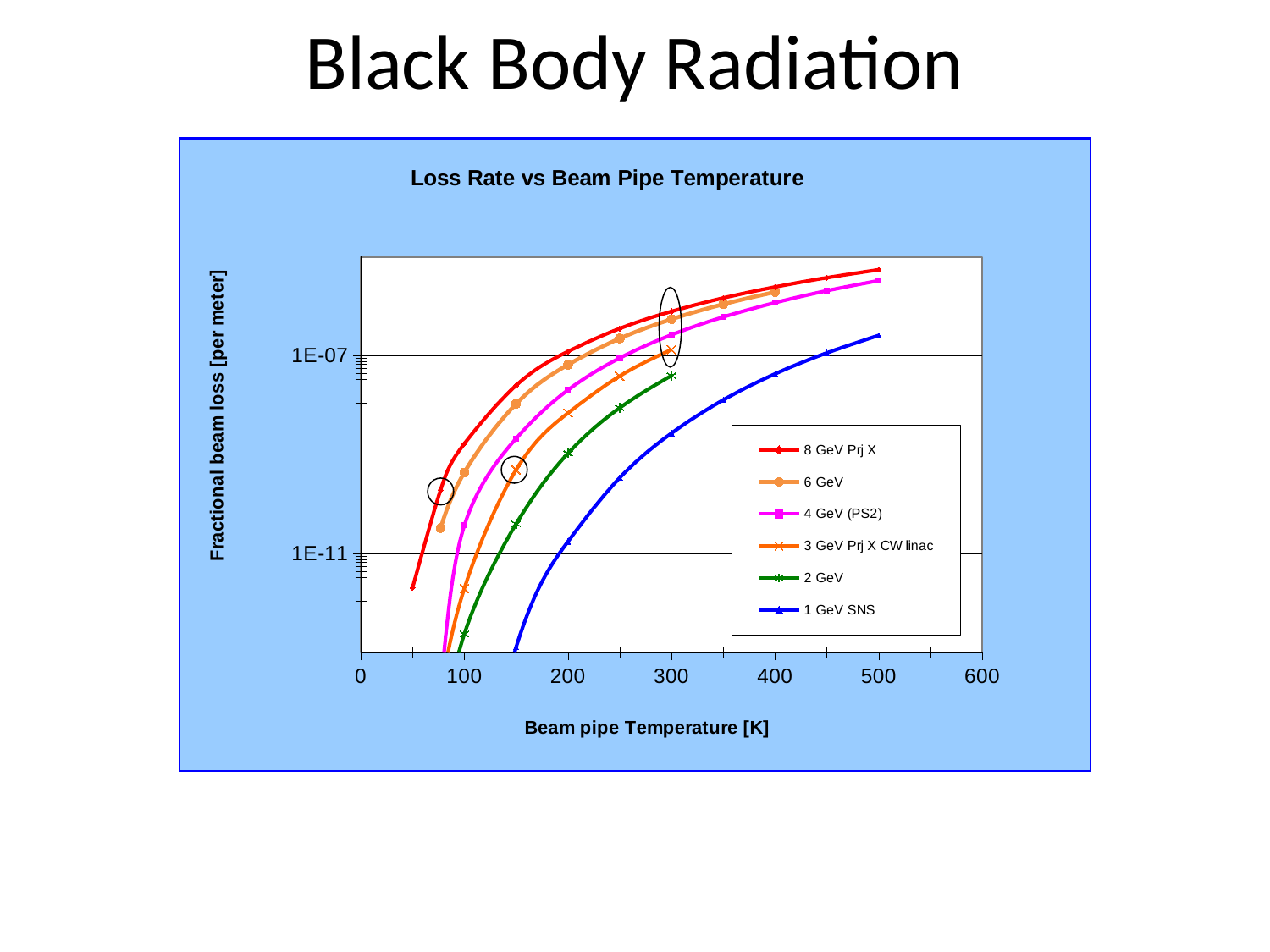
At 200 K, which series has the larger fractional beam loss, 4 GeV (PS2) or 2 GeV? 4 GeV (PS2) Is the value for 2 GeV at 200 K greater or less than 1E-07? less Is the value for 8 GeV Prj X at 300 K greater or less than 1E-07? greater What kind of chart is shown on the slide? line chart Which series has the highest fractional beam loss at 500 K? 8 GeV Prj X At 300 K, which series has the larger fractional beam loss, 8 GeV Prj X or 1 GeV SNS? 8 GeV Prj X Does the fractional beam loss rise or fall as beam pipe temperature increases? rise What is the label of the x axis? Beam pipe Temperature [K] How many series does the legend list? 6 What is the title of the chart? Loss Rate vs Beam Pipe Temperature Is the value for 1 GeV SNS at 150 K greater or less than 1E-11? less Which series has the lowest fractional beam loss at 300 K? 1 GeV SNS